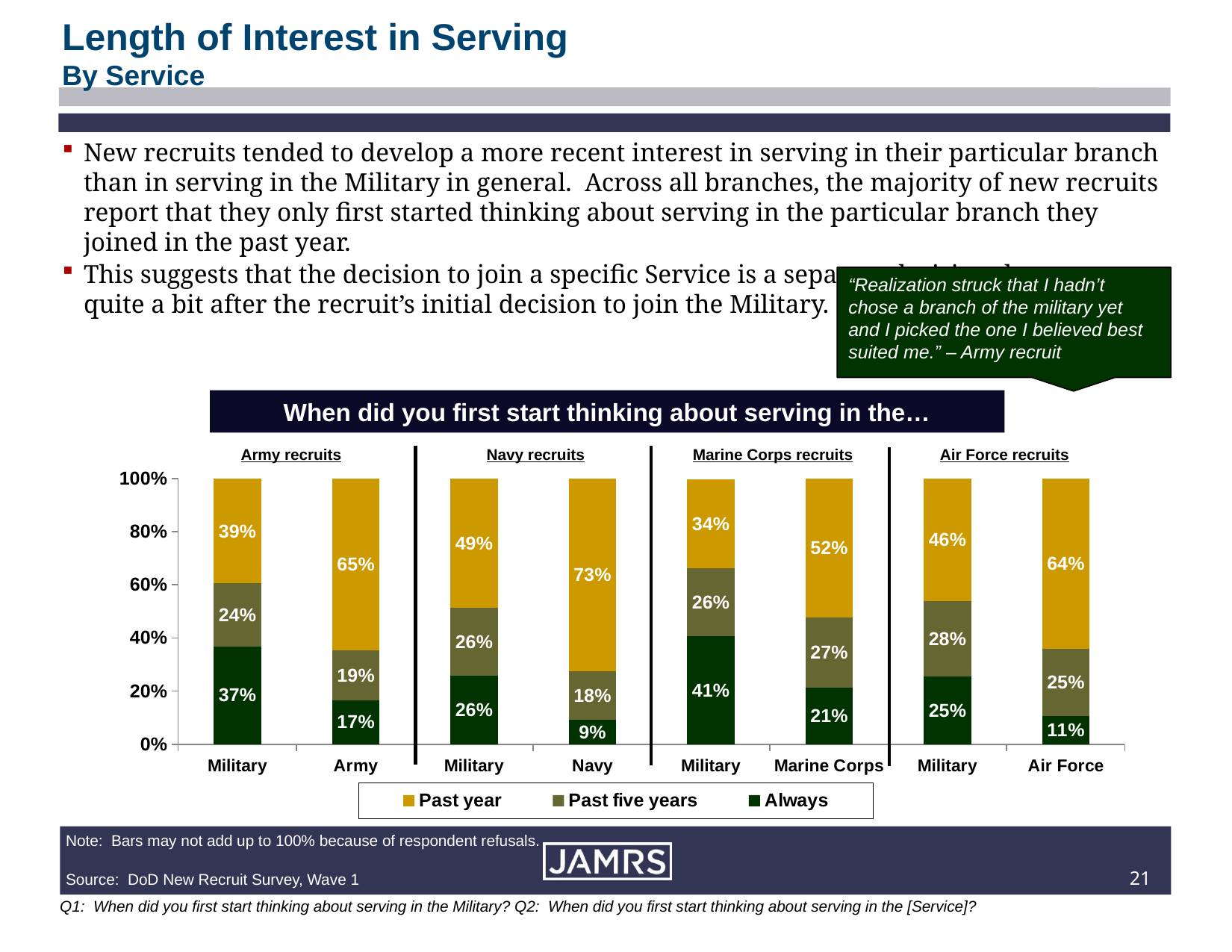
What kind of chart is shown on the slide? Stacked bar chart In the Marine Corps recruits panel, what is the 'Past five years' value for the Military bar? 26% In the Army recruits panel, how much larger is the 'Past year' value for the Army bar than for the Military bar? 26 percentage points In the Navy recruits panel, what is the 'Always' value for the Navy bar? 9% Which bar has the lowest 'Always' value? Navy How many series does the chart legend list? 3 In the Marine Corps recruits panel, which bar has the larger 'Always' value, Military or Marine Corps? Military In the Air Force recruits panel, what is the 'Always' value for the Military bar? 25% In the Army recruits panel, what percentage of the Army bar is 'Past year'? 65% Which bar has the highest 'Past year' value? Navy How many bars are plotted in the chart? 8 What is the title shown above the chart? When did you first start thinking about serving in the…